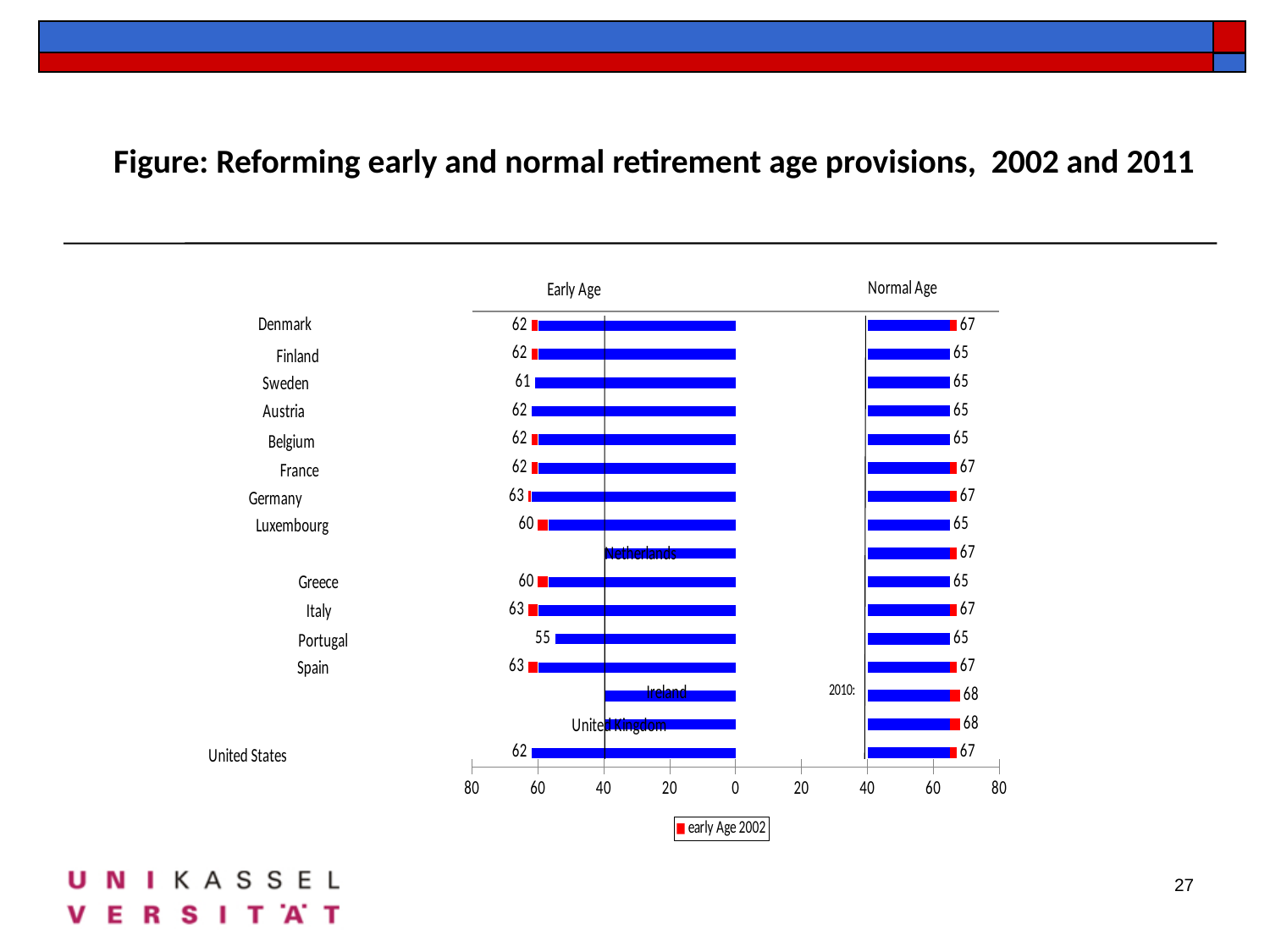
Which country has the lowest Early Age value? Portugal What is the Early Age value shown for Germany? 63 What kind of chart is shown on the slide? bar chart What is the Normal Age value shown for Luxembourg? 65 Is the Early Age value for Portugal greater or less than 60? less Which has a higher Early Age value, Luxembourg or Italy? Italy What is the difference between the Normal Age and Early Age values for Denmark? 5 What is the highest Normal Age value shown on the chart? 68 What is the title of the figure on the slide? Figure: Reforming early and normal retirement age provisions, 2002 and 2011 What is the Normal Age value shown for Ireland? 68 How many countries are listed on the chart? 16 What is the Early Age value shown for Portugal? 55